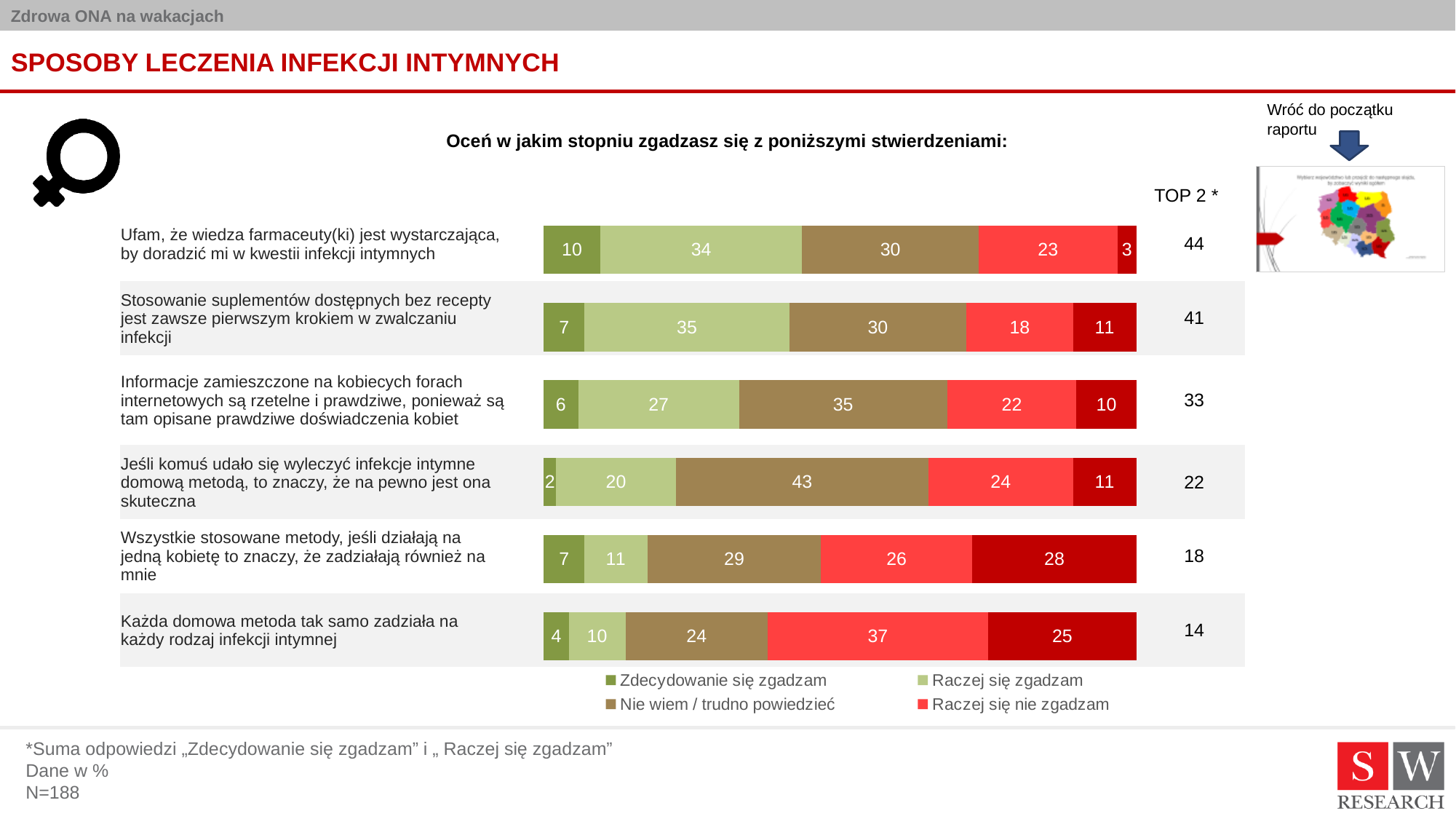
Which is larger: the 'Raczej się zgadzam' value for 'Stosowanie suplementów dostępnych bez recepty...' or for 'Informacje zamieszczone na kobiecych forach internetowych...'? Stosowanie suplementów dostępnych bez recepty... Which statement has the lowest TOP 2 value? Każda domowa metoda tak samo zadziała na każdy rodzaj infekcji intymnej What is the difference between the TOP 2 values of the first statement (44) and the last statement (14)? 30 What type of chart is shown on the slide? stacked bar chart What is the 'Zdecydowanie się zgadzam' value for the statement 'Ufam, że wiedza farmaceuty(ki) jest wystarczająca, by doradzić mi w kwestii infekcji intymnych'? 10 What is the 'Raczej się nie zgadzam' value for the statement 'Każda domowa metoda tak samo zadziała na każdy rodzaj infekcji intymnej'? 37 What is the sum of 'Zdecydowanie się zgadzam' and 'Raczej się zgadzam' for the statement 'Wszystkie stosowane metody, jeśli działają na jedną kobietę to znaczy, że zadziałają również na mnie'? 18 Which statement has the highest TOP 2 value? Ufam, że wiedza farmaceuty(ki) jest wystarczająca, by doradzić mi w kwestii infekcji intymnych How many series does the chart legend list? 4 How many statements (categories) are plotted in the chart? 6 What is the 'Nie wiem / trudno powiedzieć' value for the statement 'Jeśli komuś udało się wyleczyć infekcje intymne domową metodą, to znaczy, że na pewno jest ona skuteczna'? 43 What is the TOP 2 value for the statement 'Stosowanie suplementów dostępnych bez recepty jest zawsze pierwszym krokiem w zwalczaniu infekcji'? 41